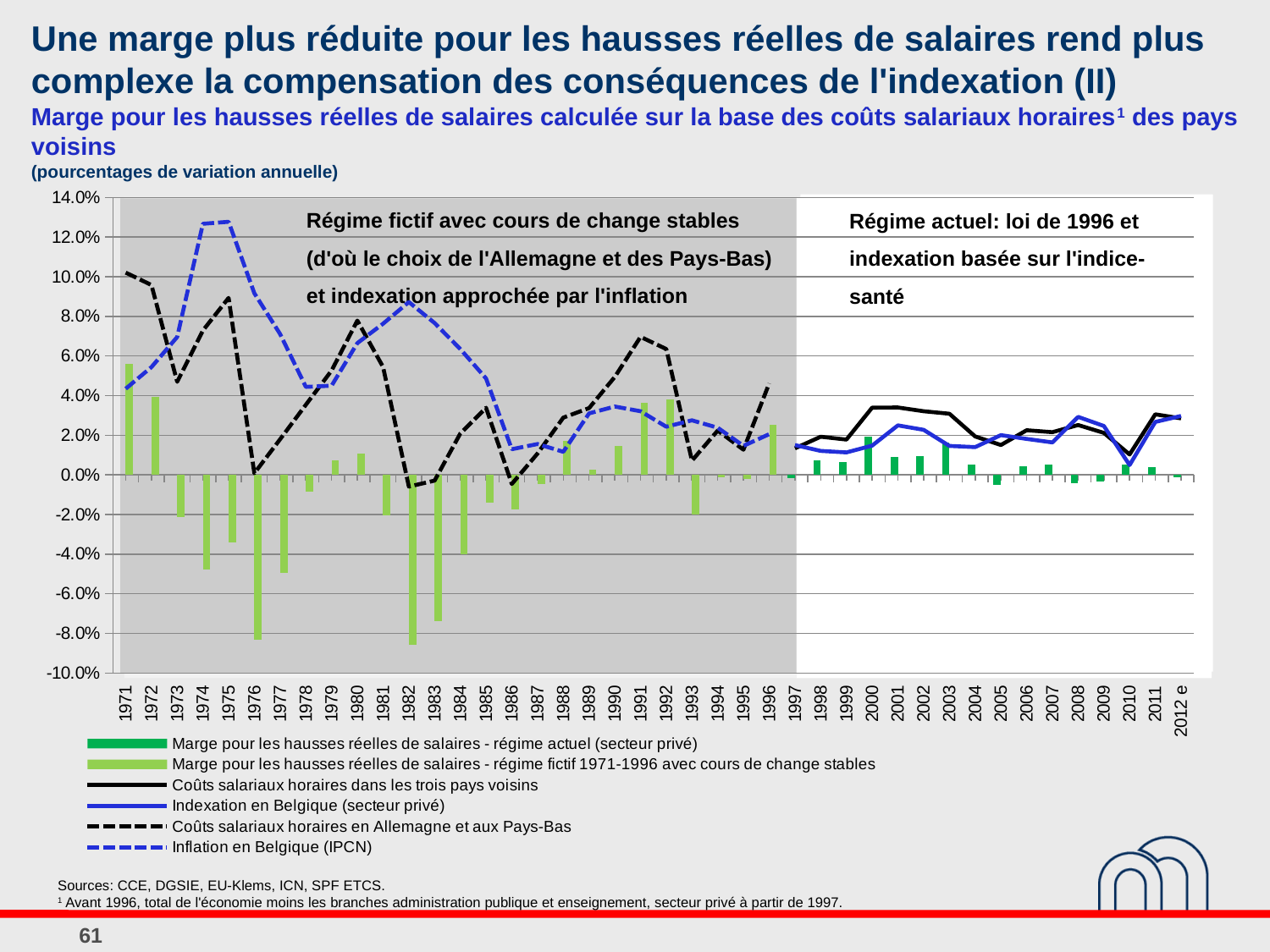
Which year has the larger régime fictif margin bar: 1976 or 1977? 1977 Which is larger in 1974: 'Inflation en Belgique (IPCN)' or 'Coûts salariaux horaires en Allemagne et aux Pays-Bas'? Inflation en Belgique (IPCN) Is the 'Inflation en Belgique (IPCN)' value in 1974 greater or less than 12.0%? greater How many years are shown on the x axis (from 1971 to 2012 e)? 42 Is the 1971 bar for the régime fictif margin greater or less than 4.0%? greater What label is given to the shaded left-hand period of the chart? Régime fictif avec cours de change stables Is the 1976 bar for the régime fictif margin greater or less than -6.0%? less How many series does the legend list? 6 What kind of chart is shown on the slide? A combined bar and line chart Which year has the highest bar for 'Marge pour les hausses réelles de salaires - régime fictif 1971-1996 avec cours de change stables'? 1971 Does the 'Inflation en Belgique (IPCN)' line rise or fall from 1975 to 1978? fall